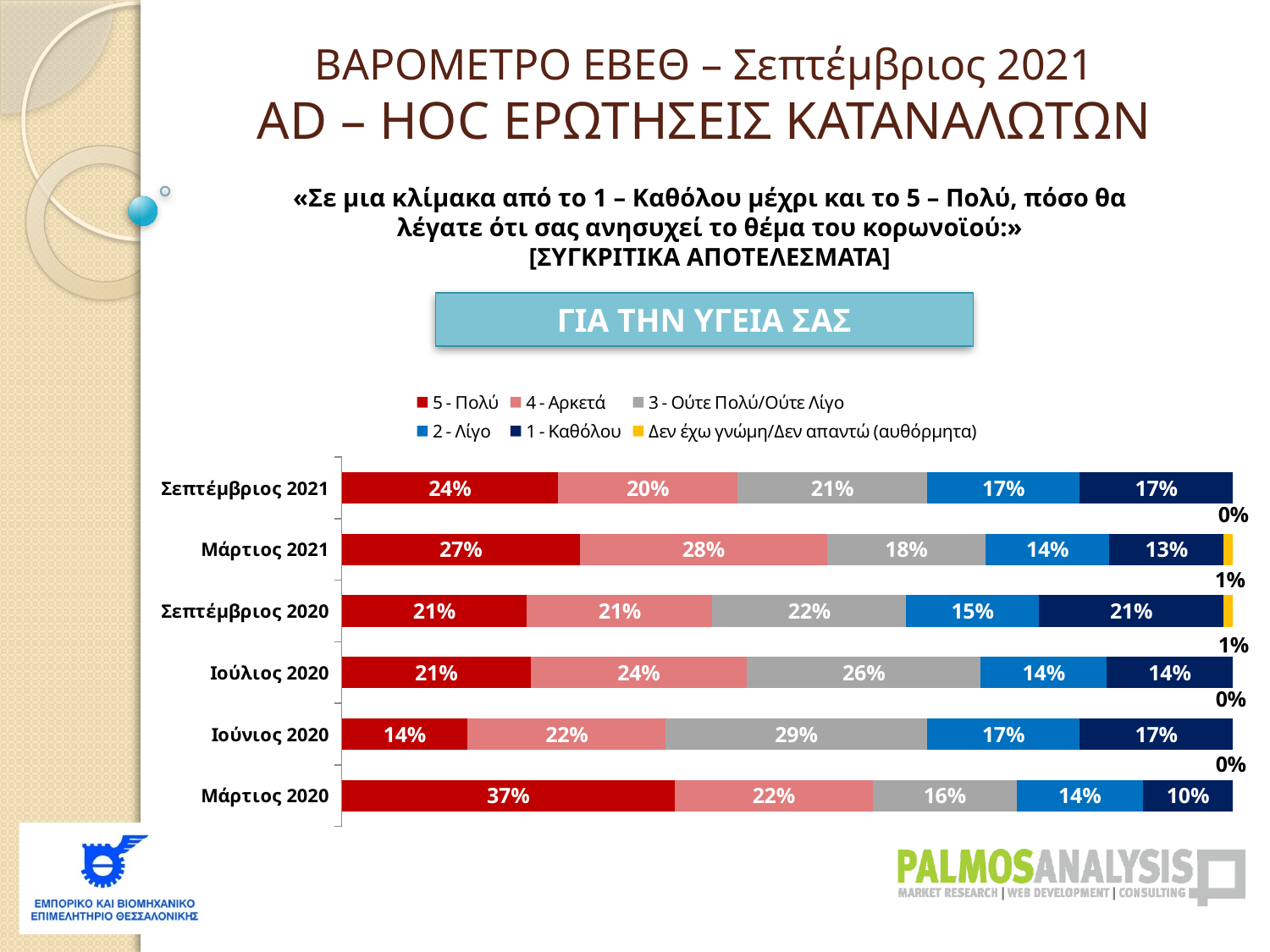
What is the value of 'Δεν έχω γνώμη/Δεν απαντώ (αυθόρμητα)' for Μάρτιος 2021? 1% What is the difference in '5 - Πολύ' between Μάρτιος 2021 and Σεπτέμβριος 2021? 3 percentage points How many survey periods (categories) are shown on the chart? 6 Which has the larger '4 - Αρκετά' value, Μάρτιος 2021 or Ιούλιος 2020? Μάρτιος 2021 What is the value of '5 - Πολύ' for Μάρτιος 2020? 37% How many series does the chart legend list? 6 Which survey period has the lowest value for '5 - Πολύ'? Ιούνιος 2020 What is the value of '3 - Ούτε Πολύ/Ούτε Λίγο' for Ιούνιος 2020? 29% What text appears in the blue box above the chart? ΓΙΑ ΤΗΝ ΥΓΕΙΑ ΣΑΣ What is the value of '1 - Καθόλου' for Σεπτέμβριος 2020? 21% Which survey period has the highest value for '5 - Πολύ'? Μάρτιος 2020 What kind of chart is shown on the slide? Stacked bar chart